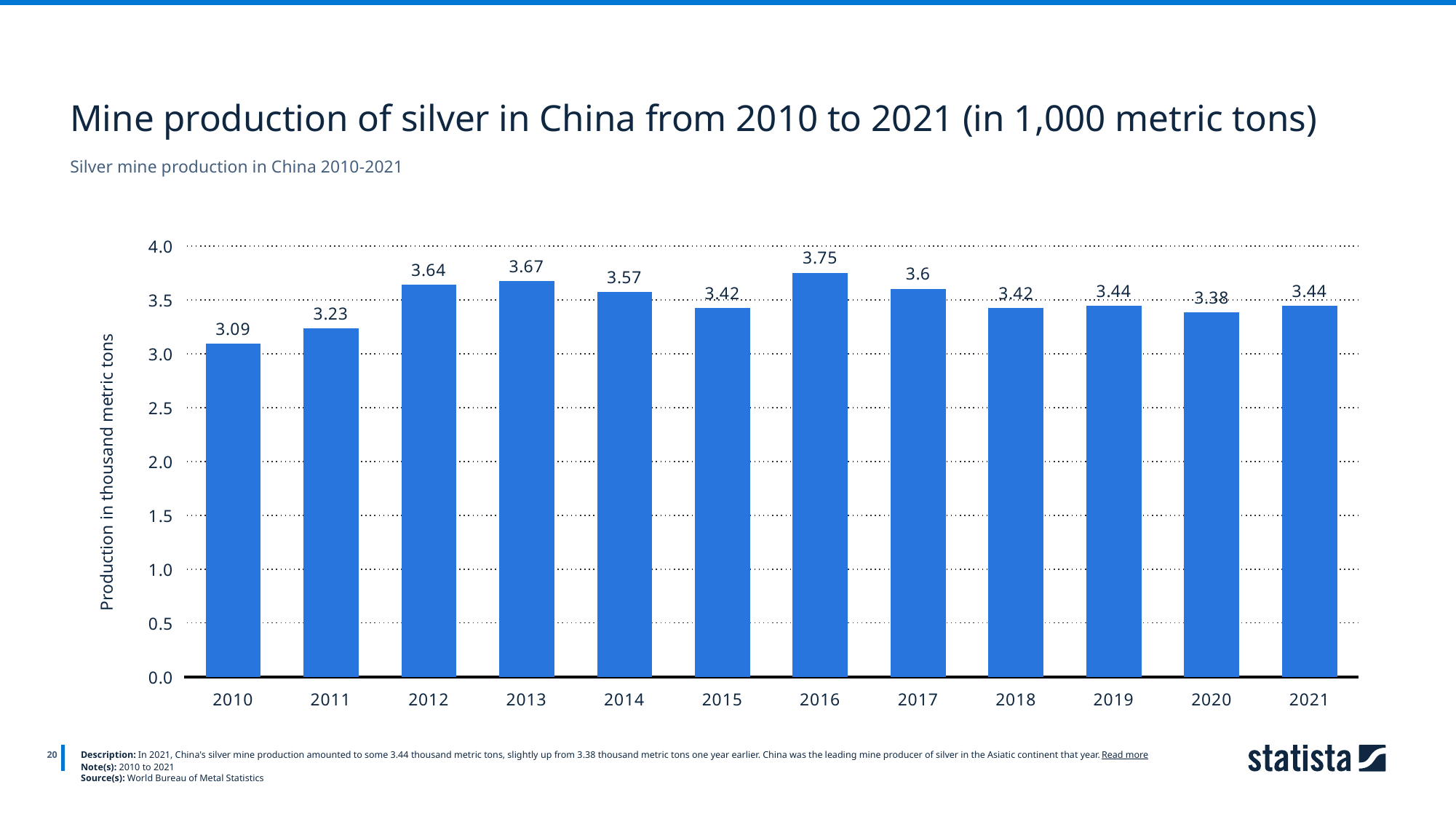
What is the difference in silver mine production between 2021 and 2020? 0.06 What was China's silver mine production in 2016? 3.75 What is the label of the y axis? Production in thousand metric tons What kind of chart is shown on the slide? Bar chart What is the difference in silver mine production between 2016 and 2010? 0.66 What was China's silver mine production in 2020? 3.38 Which year had the highest silver mine production? 2016 Is the value for 2011 greater or less than 3.5? less How many years are shown on the chart? 12 Which year had the lowest silver mine production? 2010 Which year had higher silver mine production, 2013 or 2017? 2013 What was China's silver mine production in 2010? 3.09